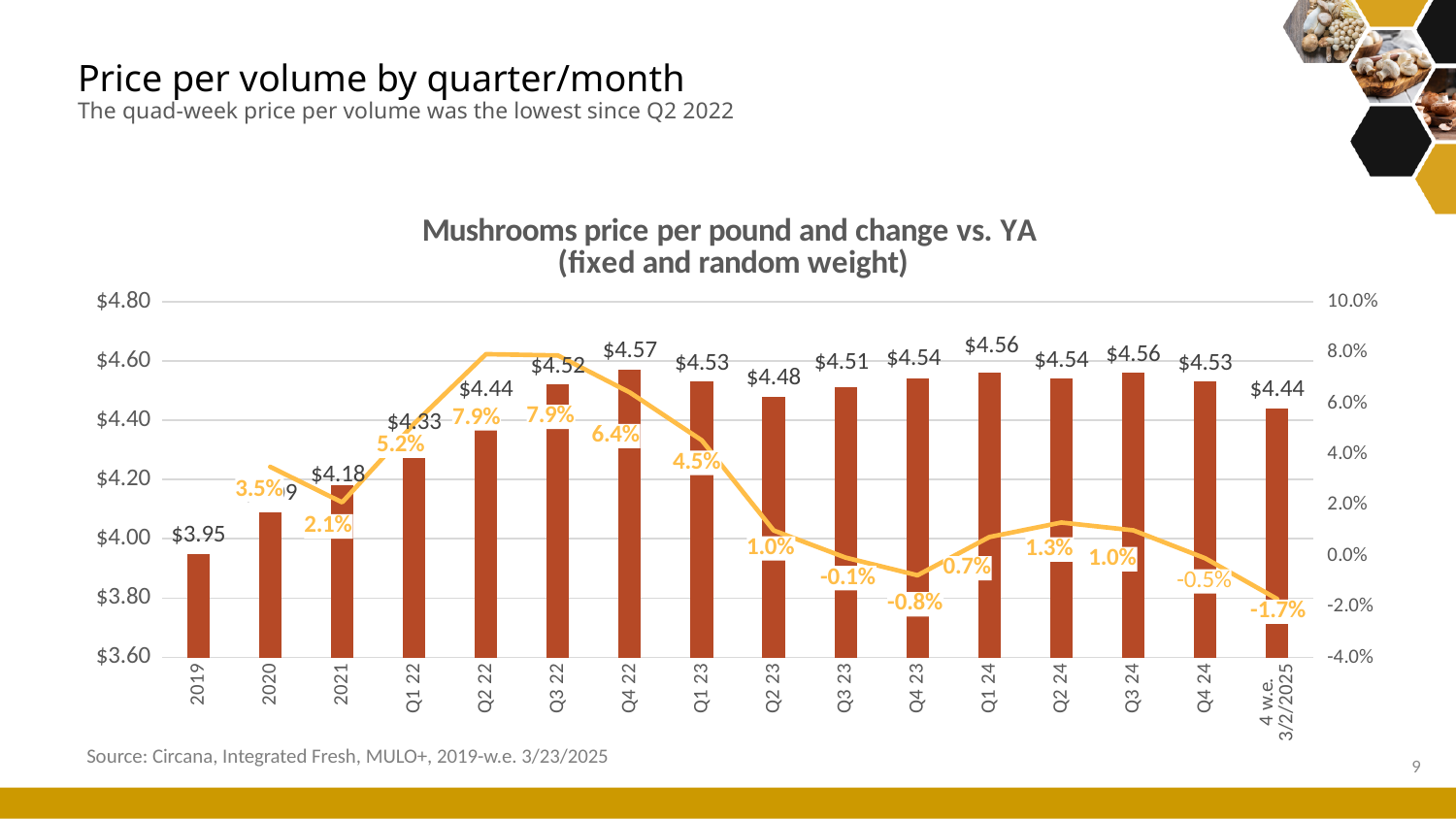
What is the mushrooms price per pound for Q4 22? $4.57 What is the change vs. YA shown for Q1 23? 4.5% Which period has the lowest change vs. YA on the line? 4 w.e. 3/2/2025 What kind of chart is this? Bar chart with a line How many periods are shown on the x axis? 16 Which period has the highest price per pound? Q4 22 Which period has the lowest price per pound? 2019 What is the title of the chart? Mushrooms price per pound and change vs. YA (fixed and random weight) Is the price per pound for 2019 greater or less than $4.00? less What is the change vs. YA shown for Q4 23? -0.8% Which has the higher price per pound, Q1 24 or Q2 24? Q1 24 What is the difference in price per pound between Q4 22 and 4 w.e. 3/2/2025? $0.13